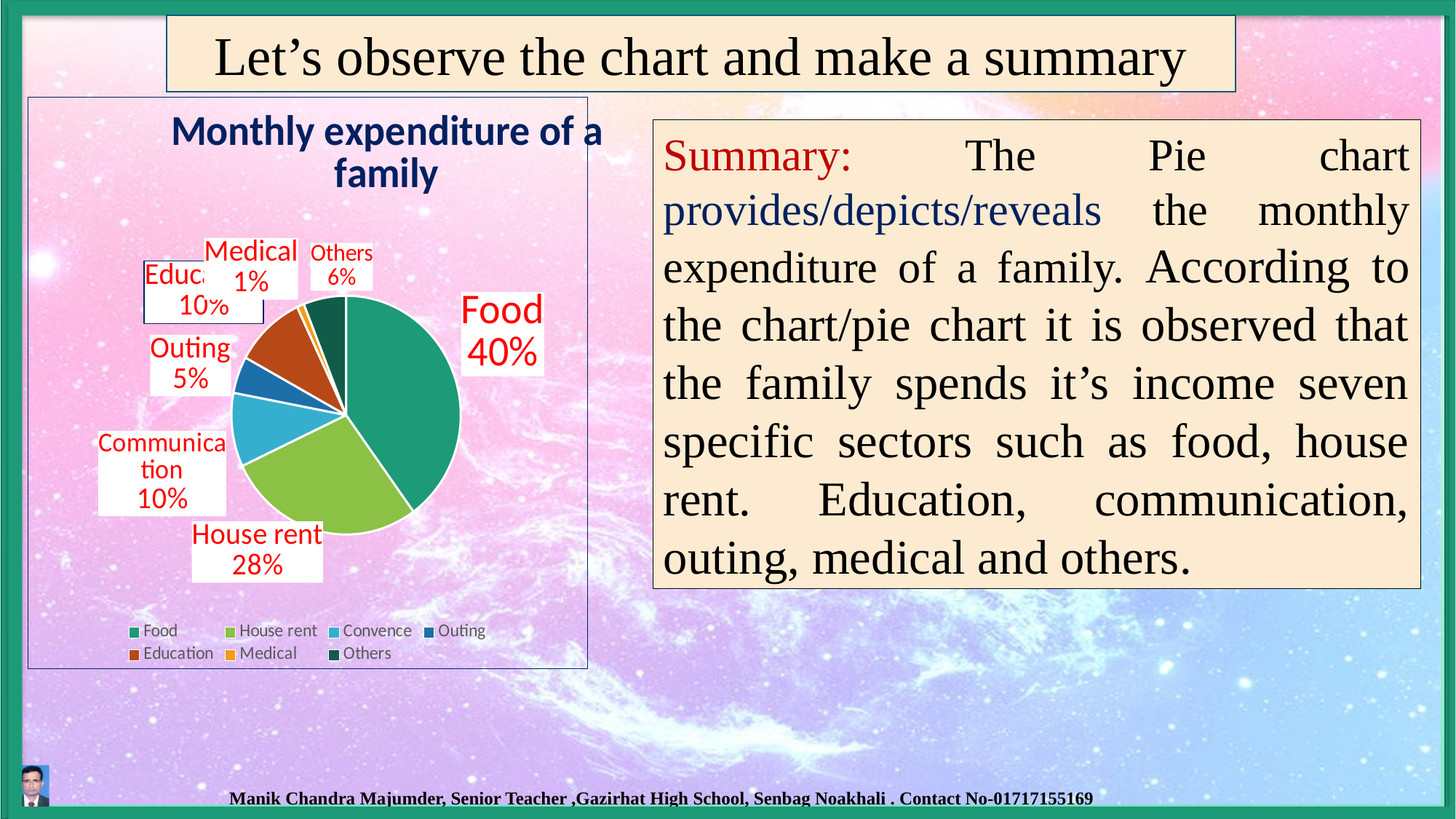
What percentage of the monthly expenditure goes to House rent? 28% What percentage of the monthly expenditure goes to Food? 40% What is the difference between the Food share and the House rent share? 12% What is the title of the chart? Monthly expenditure of a family What percentage of the monthly expenditure goes to Outing? 5% What percentage of the monthly expenditure goes to Others? 6% How many entries does the chart's legend list? 7 Which sector has the smallest share of the monthly expenditure? Medical What percentage of the monthly expenditure goes to Medical? 1% Which sector has the largest share of the monthly expenditure? Food Which is larger, the share for Others or the share for Outing? Others What type of chart is shown on the slide? Pie chart